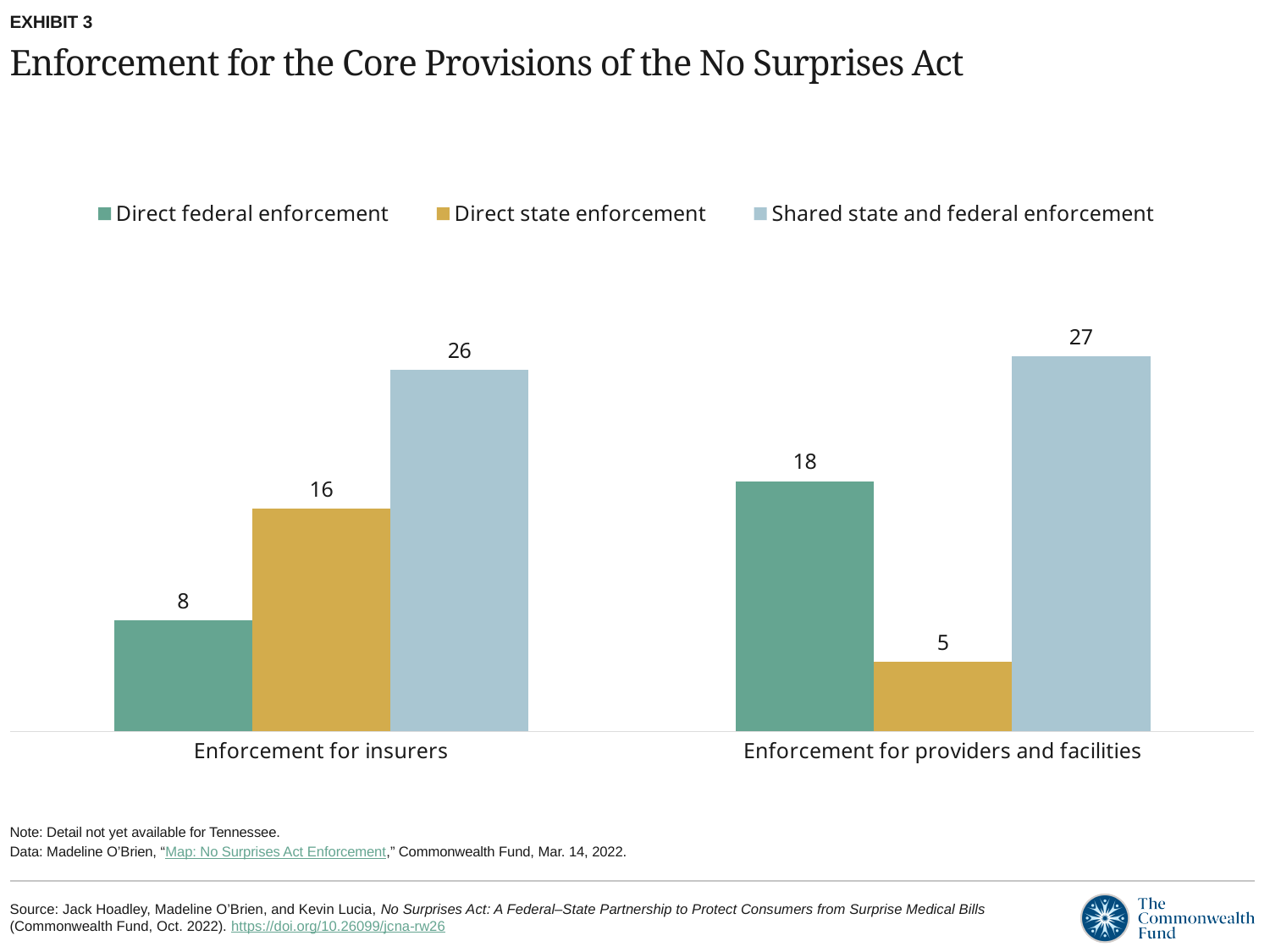
Which is larger: Direct state enforcement for insurers or Direct state enforcement for providers and facilities? Direct state enforcement for insurers Which series has the highest value in the Enforcement for providers and facilities category? Shared state and federal enforcement What is the total of the three values in the Enforcement for insurers category? 50 Which series has the lowest value in the Enforcement for insurers category? Direct federal enforcement How many categories are shown on the x axis? 2 What is the difference between Direct federal enforcement for providers and facilities and Direct federal enforcement for insurers? 10 How many series does the legend list? 3 What is the value for Direct state enforcement in the Enforcement for providers and facilities category? 5 What is the title of the chart? Enforcement for the Core Provisions of the No Surprises Act What is the value for Shared state and federal enforcement in the Enforcement for insurers category? 26 What kind of chart is shown on the slide? Bar chart What is the value for Direct federal enforcement in the Enforcement for insurers category? 8